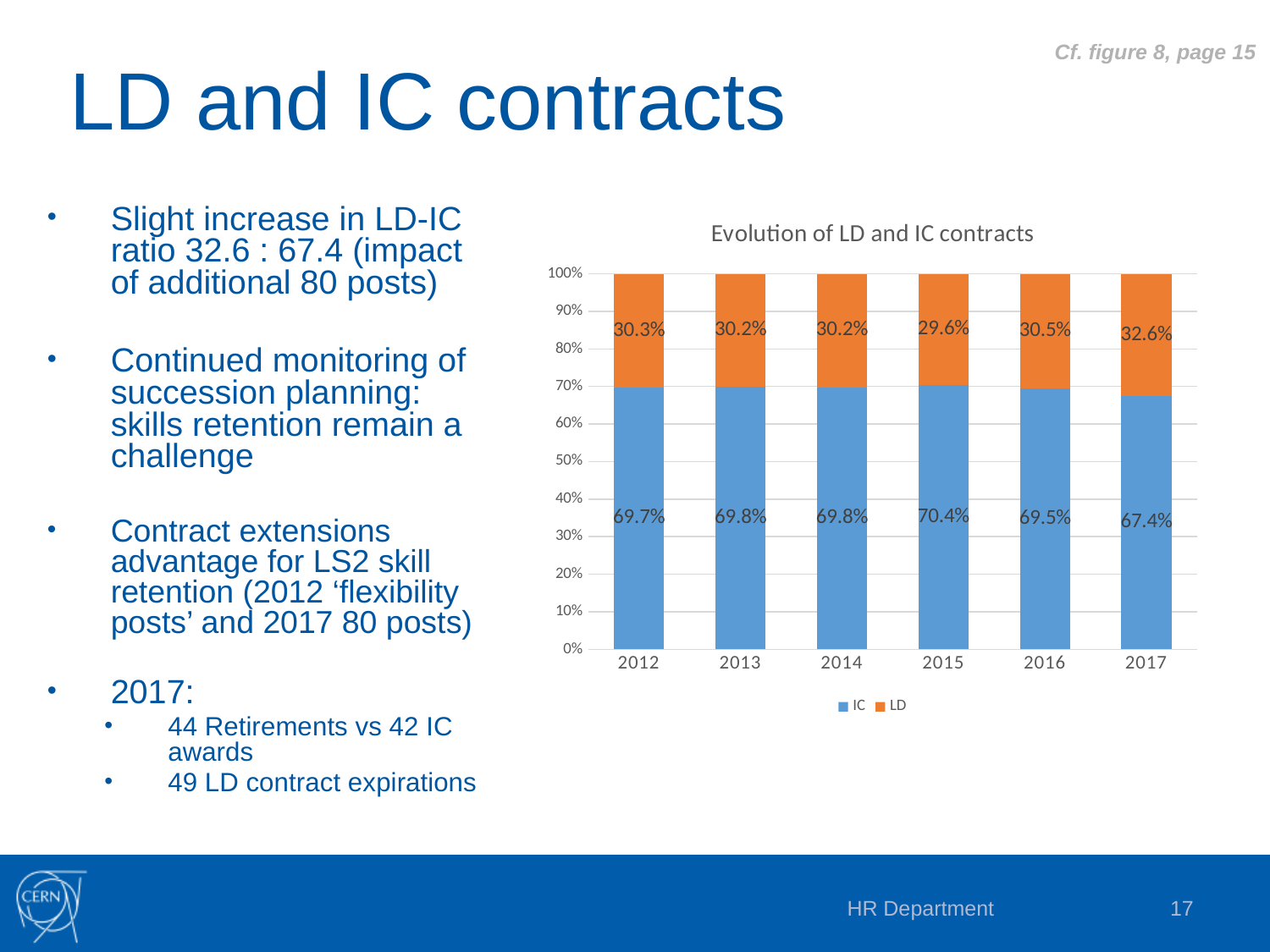
What is the title of the chart? Evolution of LD and IC contracts Which is larger, the IC share in 2015 or the IC share in 2017? 2015 What is the IC share in 2017? 67.4% What kind of chart is shown? Stacked bar chart How many series does the legend list? 2 In which year is the IC share lowest? 2017 What is the difference between the LD share in 2017 and in 2016? 2.1% In which year is the LD share highest? 2017 In which year is the IC share highest? 2015 How many years are shown on the x axis? 6 What is the LD share in 2012? 30.3% What is the LD share in 2015? 29.6%